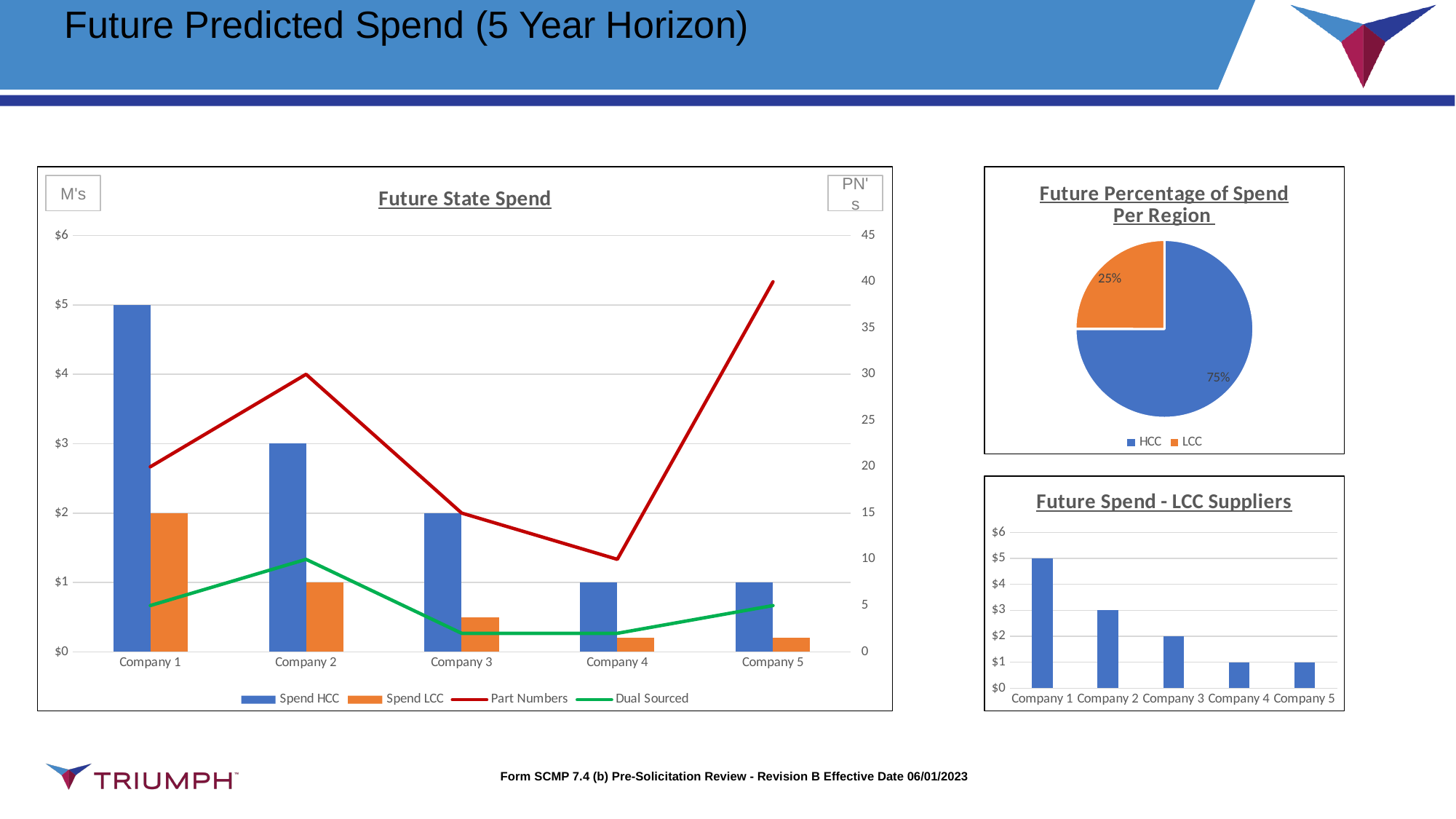
In the Future State Spend chart, does the Spend HCC series rise or fall from Company 1 to Company 4? fall In the Future State Spend chart, which company has the lowest Part Numbers value? Company 4 In the Future State Spend chart, what is the Spend HCC value for Company 1? $5 In the Future Spend - LCC Suppliers chart, what is the value for Company 2? $3 In the Future Percentage of Spend Per Region pie chart, which slice is larger, HCC or LCC? HCC In the Future State Spend chart, what is the difference between the Spend HCC values for Company 1 and Company 2? $2 How many series does the legend of the Future State Spend chart list? 4 In the Future State Spend chart, which company has the highest Part Numbers value? Company 5 In the Future State Spend chart, is the Spend LCC value for Company 3 greater or less than $1? less In the Future Percentage of Spend Per Region pie chart, what share of spend is HCC? 75% In the Future State Spend chart, what is the Part Numbers value for Company 2? 30 What kind of chart is the Future Spend - LCC Suppliers chart? bar chart